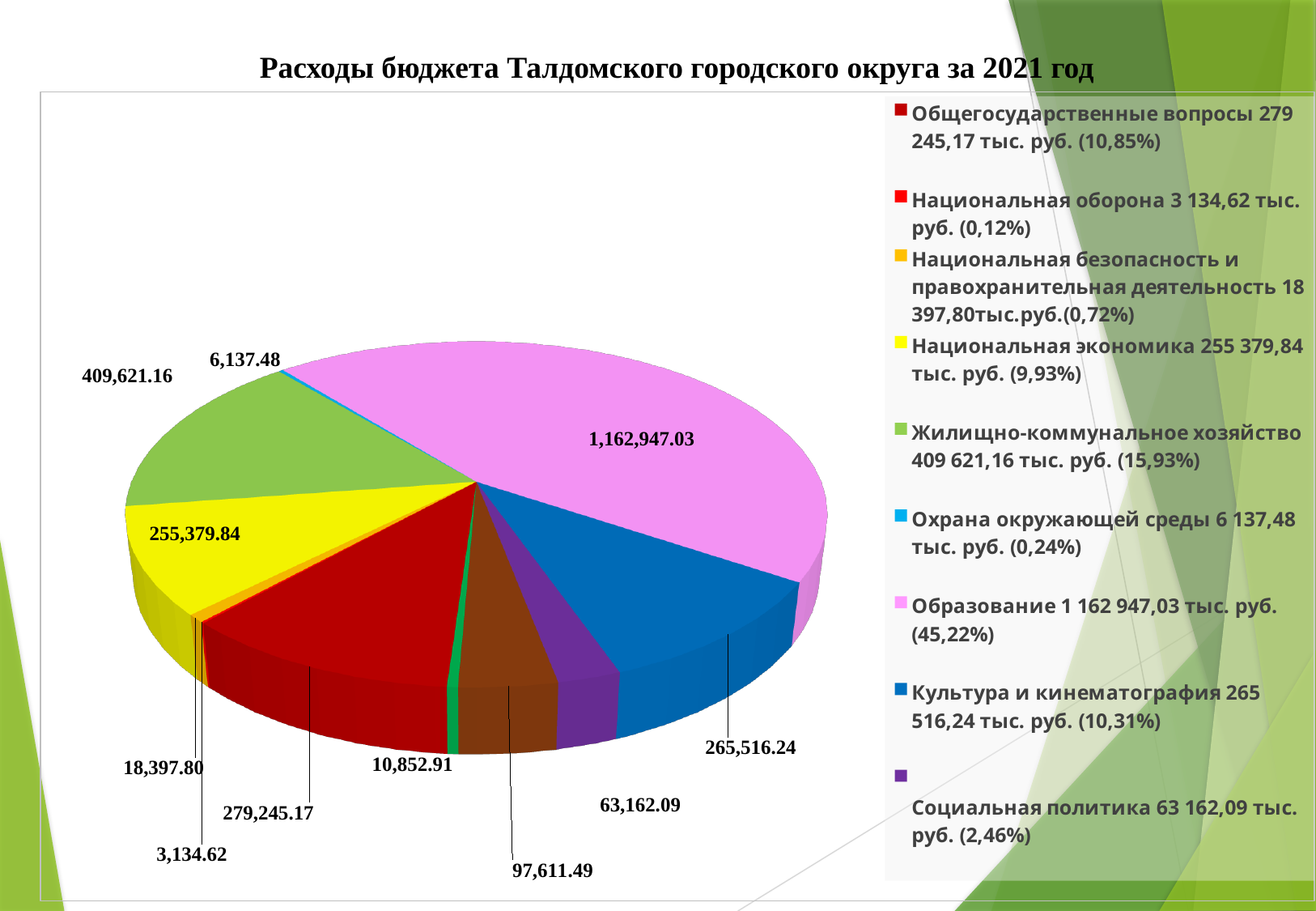
How many entries does the legend list? 9 What value is labelled on the slice for Социальная политика? 63,162.09 What value is labelled on the slice for Культура и кинематография? 265,516.24 What value is labelled on the slice for Жилищно-коммунальное хозяйство? 409,621.16 What is the difference between the values for Жилищно-коммунальное хозяйство and Национальная экономика? 154,241.32 Which category has the largest slice of the pie? Образование What share of the pie does Национальная экономика account for, according to the legend? 9,93% How many data labels are shown around the pie? 11 Which category has the smallest slice of the pie? Национальная оборона Which is larger: Общегосударственные вопросы or Национальная экономика? Общегосударственные вопросы What share of the pie does Образование account for, according to the legend? 45,22% What kind of chart is shown on the slide? Pie chart